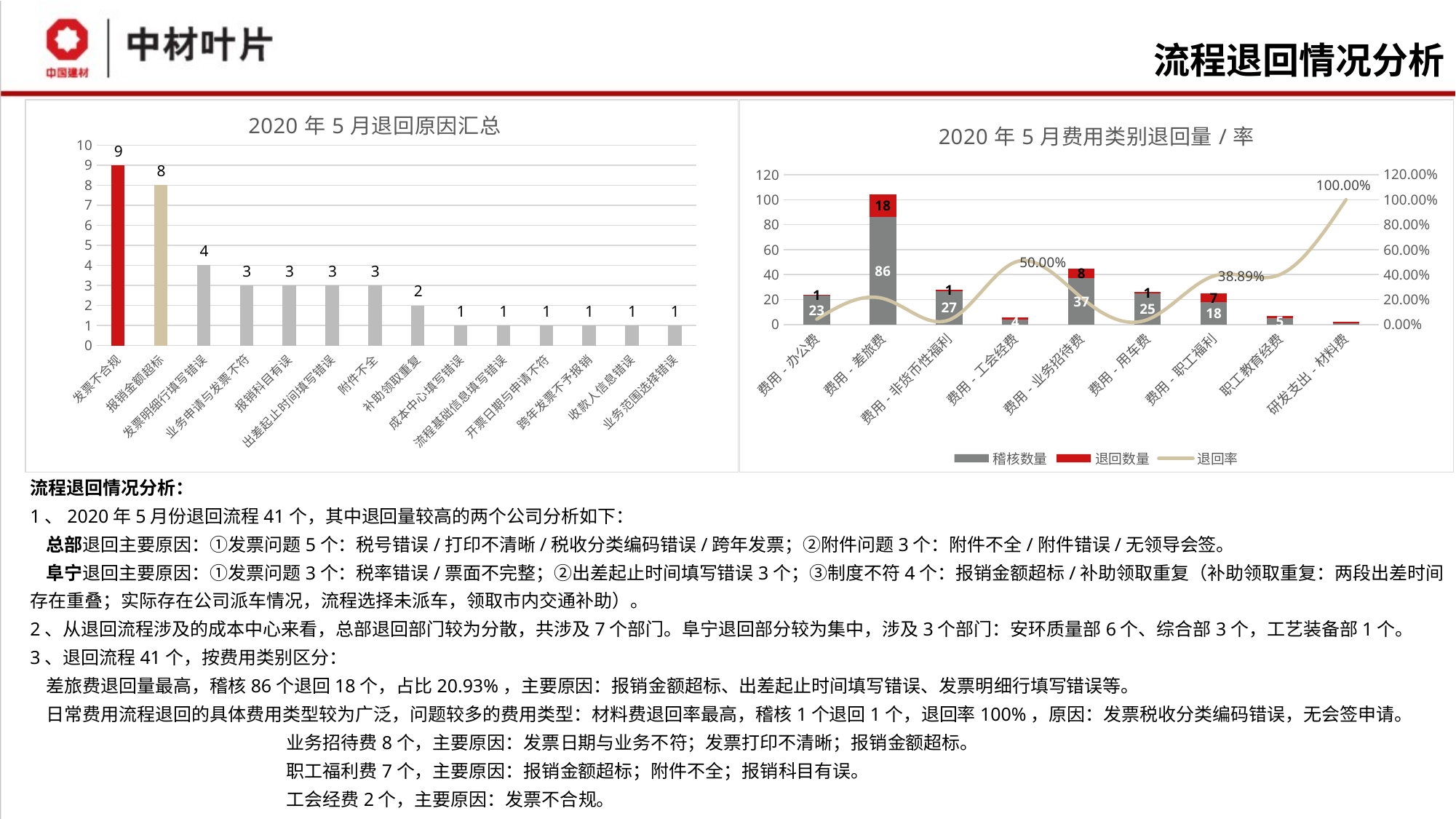
In the chart titled 2020年5月费用类别退回量/率, what is the 退回率 value for 费用-职工福利? 38.89% In the chart titled 2020年5月退回原因汇总, which is larger, 补助领取重复 or 附件不全? 附件不全 In the chart titled 2020年5月费用类别退回量/率, what is the 退回数量 value for 费用-业务招待费? 8 In the chart titled 2020年5月退回原因汇总, what is the value for 发票不合规? 9 In the chart titled 2020年5月退回原因汇总, what is the value for 发票明细行填写错误? 4 In the chart titled 2020年5月退回原因汇总, how many categories are shown on the x axis? 14 How many series does the legend list in the chart titled 2020年5月费用类别退回量/率? 3 In the chart titled 2020年5月费用类别退回量/率, what is the total of the stacked bar for 费用-差旅费? 104 In the chart titled 2020年5月费用类别退回量/率, what is the 稽核数量 value for 费用-差旅费? 86 In the chart titled 2020年5月退回原因汇总, what is the difference between 发票不合规 and 报销金额超标? 1 In the chart titled 2020年5月退回原因汇总, which category has the highest value? 发票不合规 What kind of chart is the one titled 2020年5月退回原因汇总? bar chart